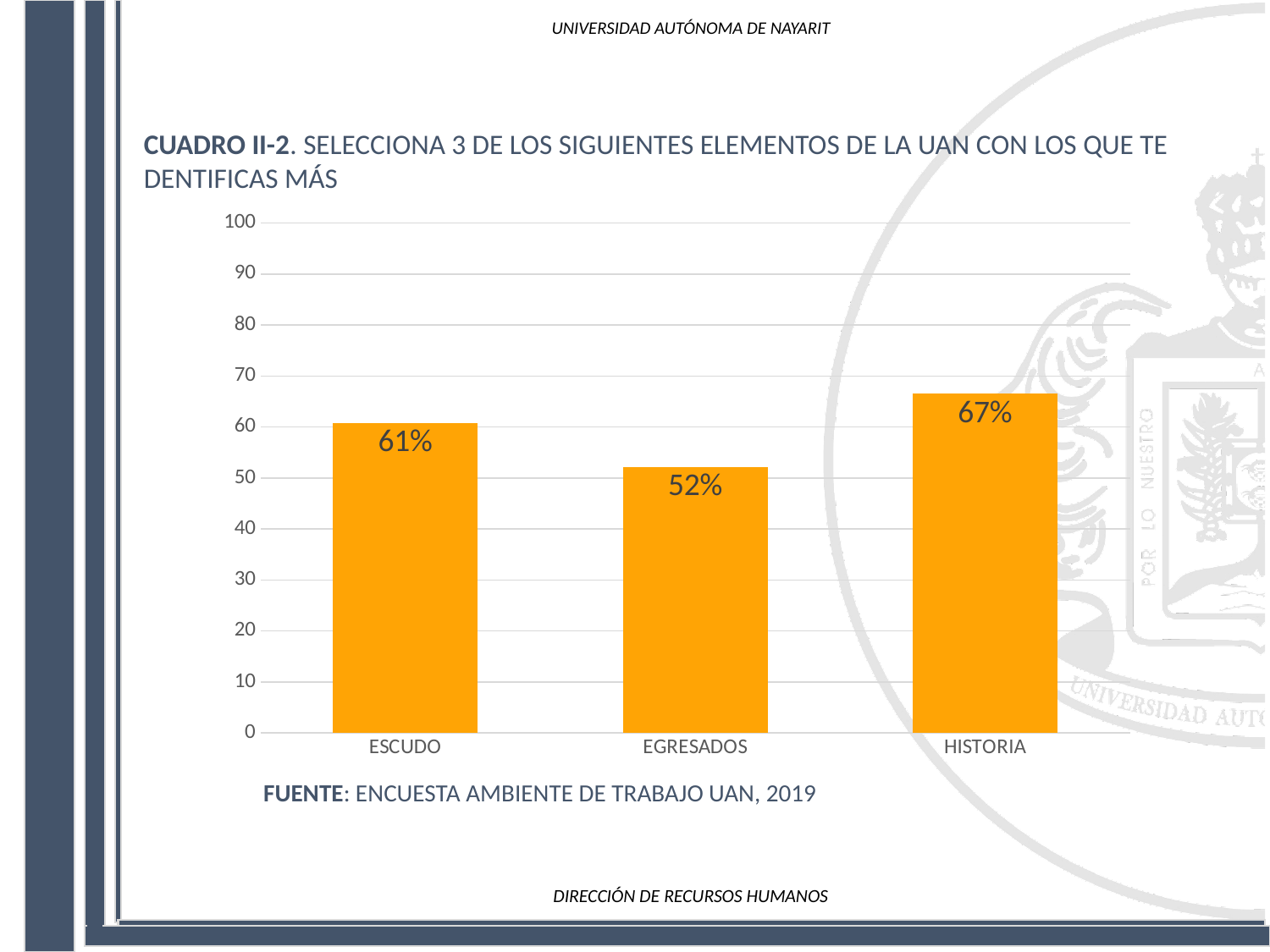
What is the difference between the values for ESCUDO and EGRESADOS? 9% Which category has the highest value? HISTORIA How many categories are shown in the chart? 3 Which category has the lowest value? EGRESADOS What is the difference between the values for HISTORIA and EGRESADOS? 15% What is the value for HISTORIA? 67% What kind of chart is shown on the slide? bar chart Is the value for EGRESADOS greater or less than 60? less Which is larger, the value for ESCUDO or the value for HISTORIA? HISTORIA What is the value for EGRESADOS? 52% What is the value for ESCUDO? 61% What source is cited below the chart? ENCUESTA AMBIENTE DE TRABAJO UAN, 2019